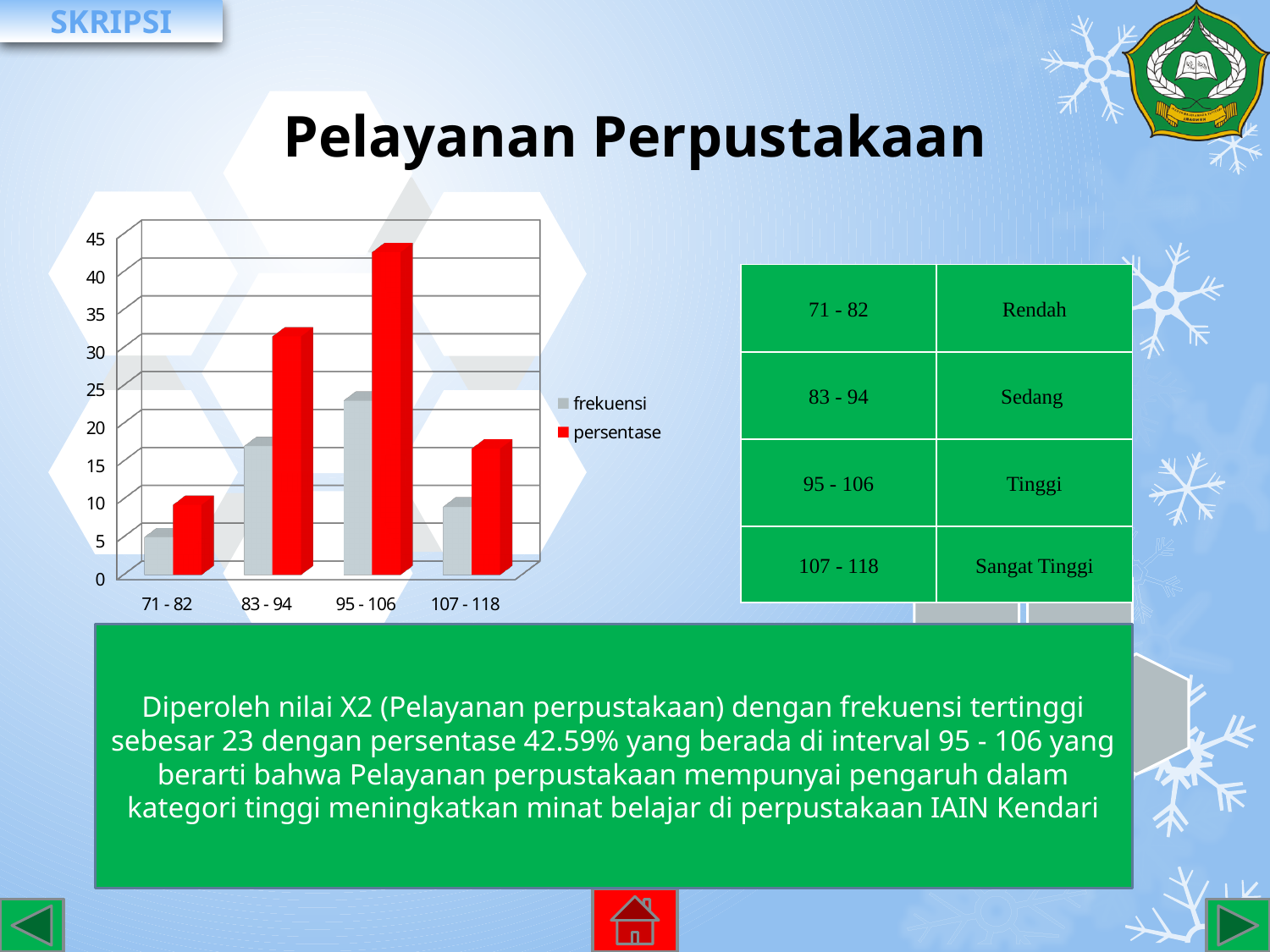
What colour are the persentase bars in the chart? red Do the frekuensi values rise steadily, fall steadily, or rise and then fall across the intervals from 71 - 82 to 107 - 118? rise and then fall How many interval categories are shown on the x axis of the chart? 4 Is the persentase value for 83 - 94 greater or less than 25? greater Is the frekuensi value for 71 - 82 greater or less than 10? less Which is larger, the persentase for 83 - 94 or the persentase for 107 - 118? 83 - 94 Which interval has the lowest frekuensi bar? 71 - 82 Is the frekuensi value for 107 - 118 greater or less than 15? less Which interval has the highest persentase bar? 95 - 106 What kind of chart is shown on the slide? bar chart How many series does the chart legend list? 2